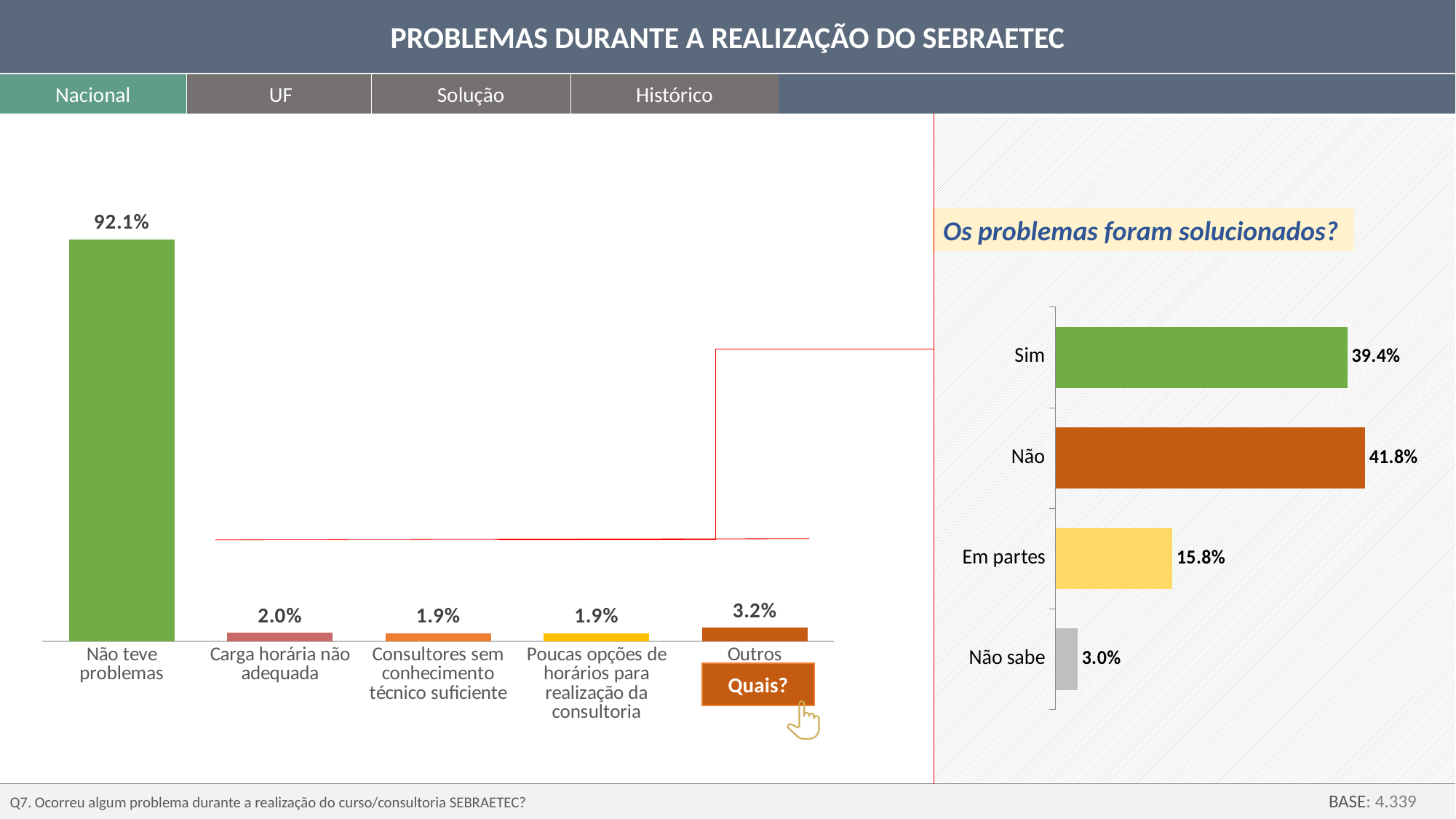
In the left chart, which category has the highest value? Não teve problemas In the chart titled 'Os problemas foram solucionados?', which is larger, 'Sim' or 'Não'? Não In the left chart, what is the difference between 'Outros' and 'Carga horária não adequada'? 1.2% In the chart titled 'Os problemas foram solucionados?', what is the value for 'Em partes'? 15.8% What kind of chart is the one titled 'Os problemas foram solucionados?'? Bar chart In the left chart, what is the value for 'Não teve problemas'? 92.1% In the chart titled 'Os problemas foram solucionados?', what is the difference between 'Não' and 'Sim'? 2.4% In the left chart, what is the value for 'Outros'? 3.2% In the left chart, how many categories are shown? 5 In the left chart, what is the value for 'Carga horária não adequada'? 2.0% In the chart titled 'Os problemas foram solucionados?', what is the value for 'Não'? 41.8% In the chart titled 'Os problemas foram solucionados?', which category has the lowest value? Não sabe